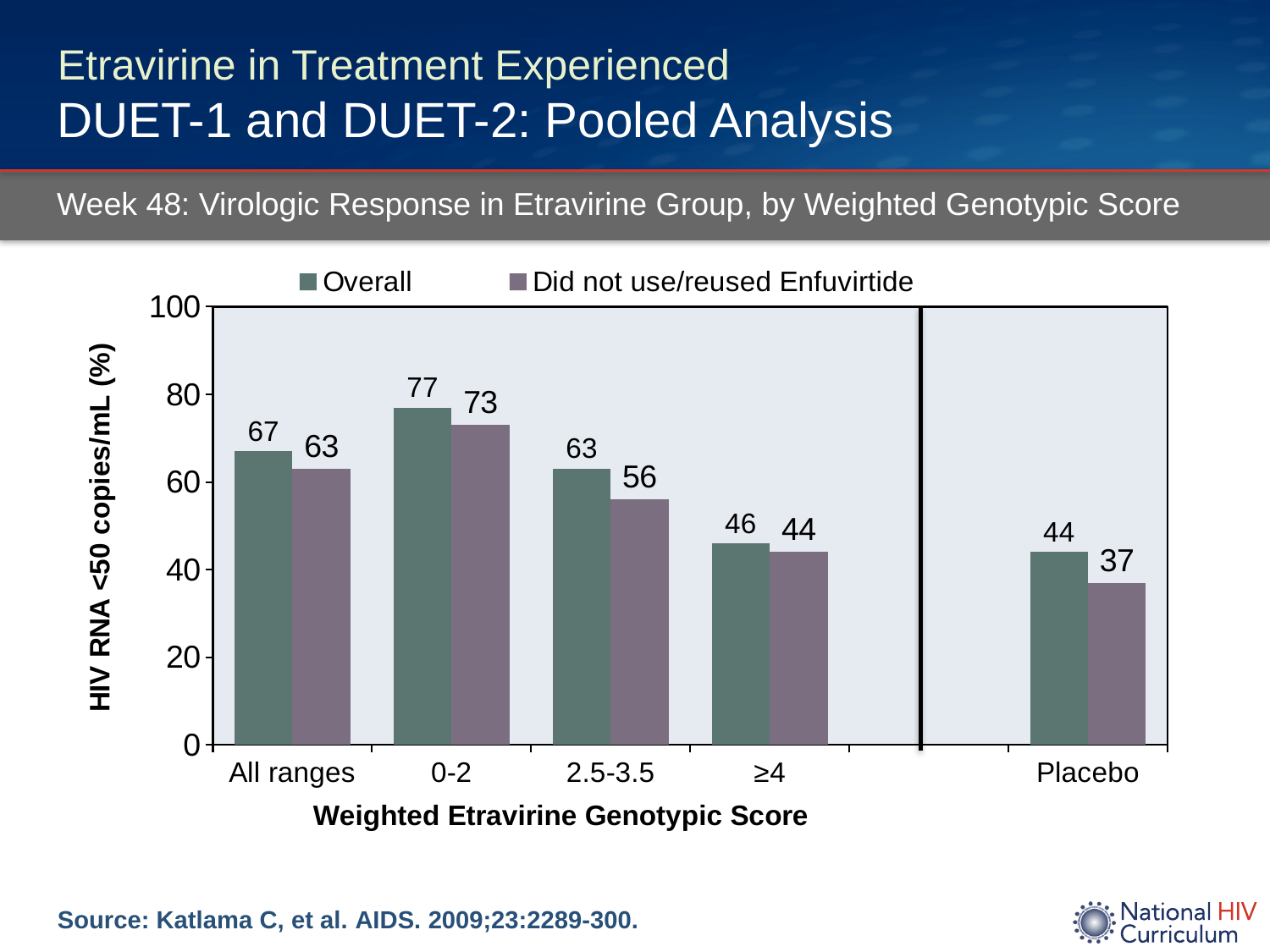
What kind of chart is shown on the slide? Bar chart How many series does the legend list? 2 How many categories are shown on the x axis? 5 What is the Overall value for the 0-2 weighted genotypic score category? 77 Which category has the lowest 'Did not use/reused Enfuvirtide' value? Placebo Which is larger: the Overall value for All ranges or the Overall value for ≥4? All ranges Which category has the highest Overall value? 0-2 What is the difference between the Overall and 'Did not use/reused Enfuvirtide' values for the 2.5-3.5 category? 7 What is the label of the y axis? HIV RNA <50 copies/mL (%) Is the Overall value for the ≥4 category greater or less than 60? less What is the 'Did not use/reused Enfuvirtide' value for the Placebo category? 37 What is the Overall value for the 2.5-3.5 category? 63